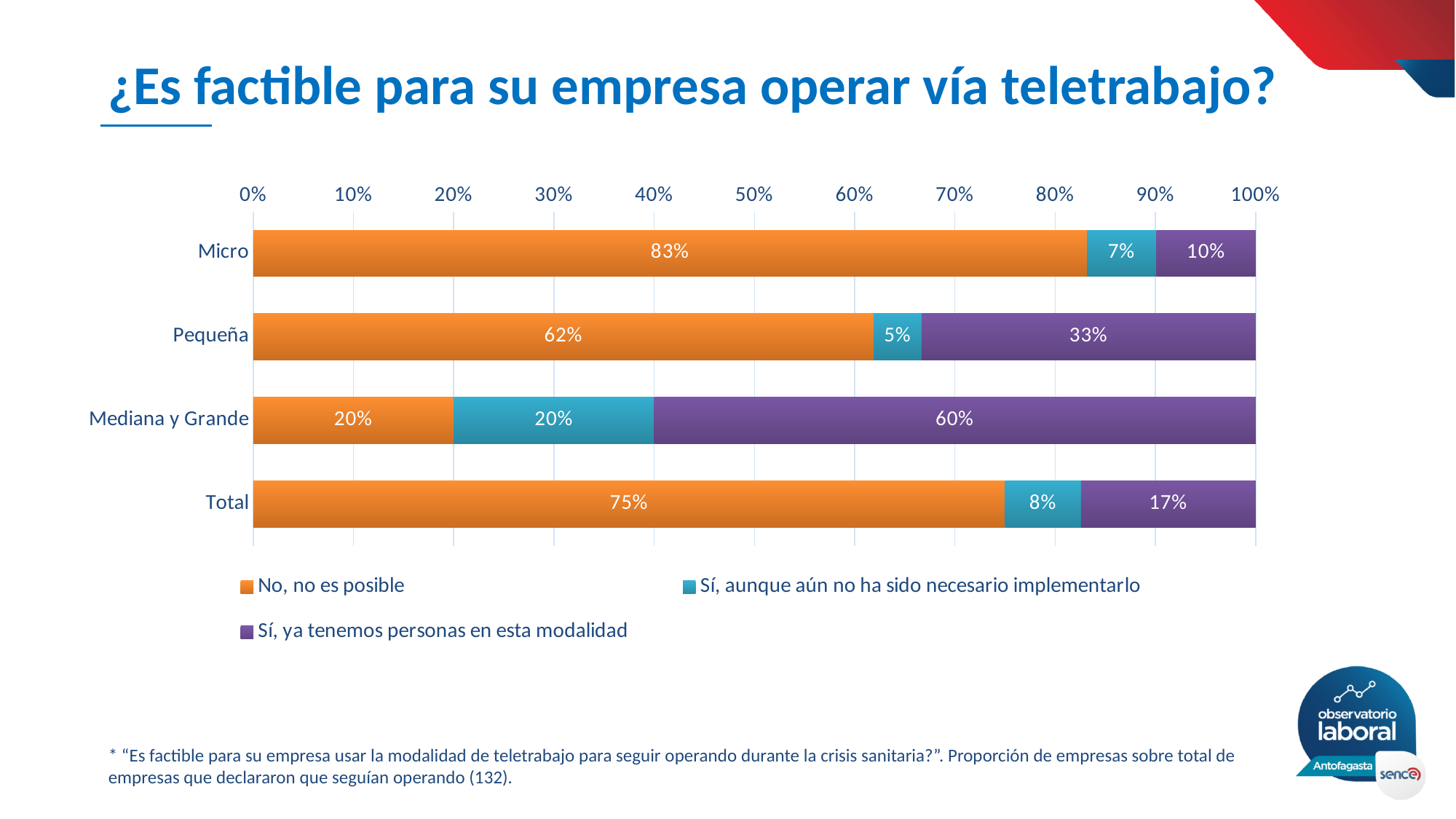
What kind of chart is shown on the slide? Stacked bar chart Which company size category has the lowest share of "Sí, ya tenemos personas en esta modalidad"? Micro What is the Total value for "No, no es posible"? 75% What percentage of Pequeña companies answered "Sí, ya tenemos personas en esta modalidad"? 33% How many series does the legend list? 3 How many categories are shown on the y axis of the chart? 4 What is the difference between the "No, no es posible" share for Micro and for Pequeña? 21 percentage points Which is larger: the "Sí, ya tenemos personas en esta modalidad" share for Mediana y Grande or for Pequeña? Mediana y Grande Which company size category has the highest share of "No, no es posible"? Micro Which colour represents "Sí, aunque aún no ha sido necesario implementarlo" in the chart? Blue (teal) What percentage of Micro companies answered "No, no es posible"? 83% What percentage of Mediana y Grande companies answered "Sí, aunque aún no ha sido necesario implementarlo"? 20%